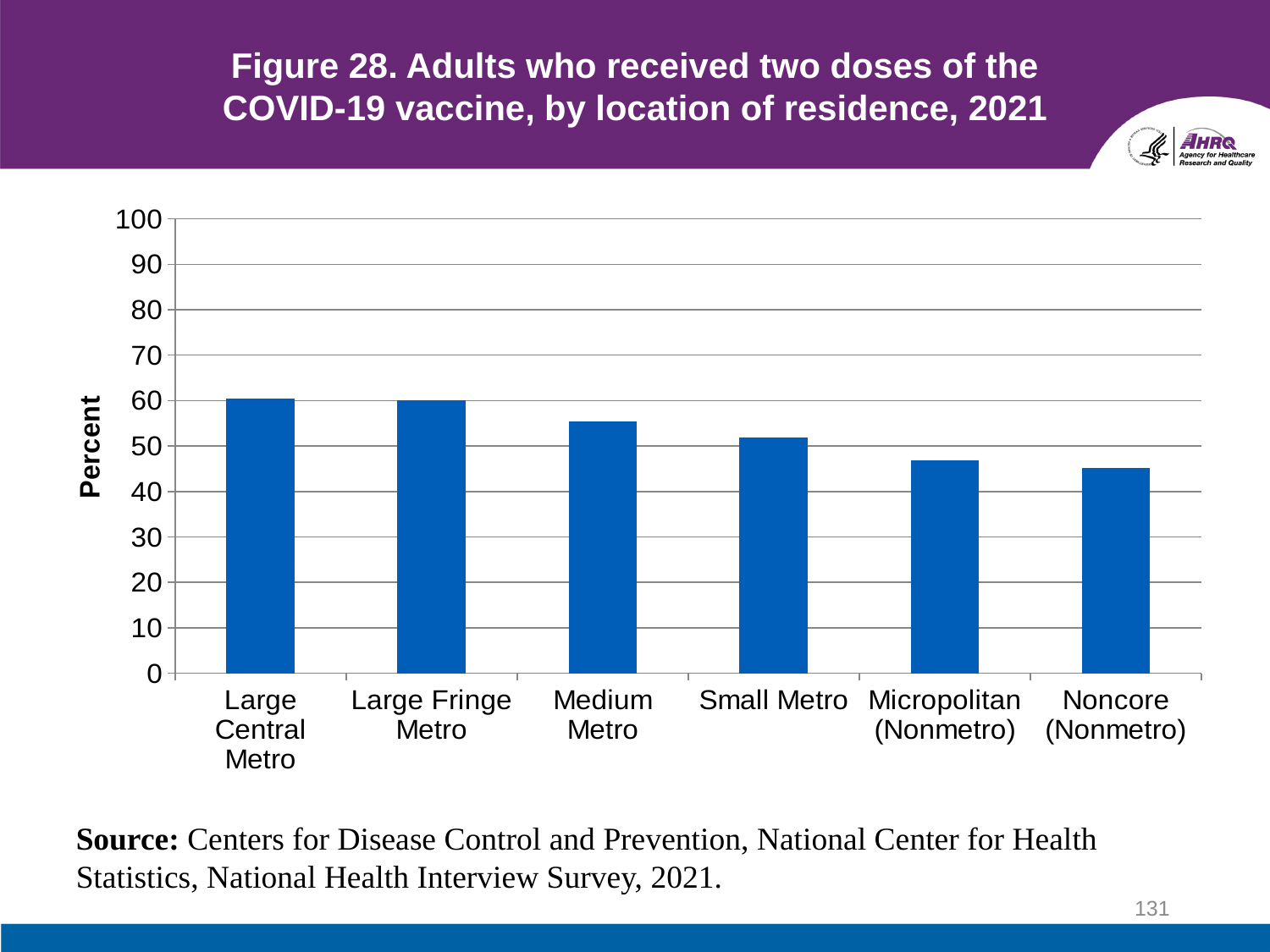
Is the value for Noncore (Nonmetro) greater or less than 50? less Which has a larger value, Large Central Metro or Noncore (Nonmetro)? Large Central Metro Is the value for Micropolitan (Nonmetro) greater or less than 50? less How many location-of-residence categories are shown on the chart? 6 What kind of chart is shown on the slide? bar chart Is the value for Large Fringe Metro greater or less than 50? greater Which has a larger value, Medium Metro or Small Metro? Medium Metro What is the label on the vertical axis of the chart? Percent Do the values rise or fall moving from Large Central Metro to Noncore (Nonmetro) along the x axis? fall What is the title of the chart? Figure 28. Adults who received two doses of the COVID-19 vaccine, by location of residence, 2021